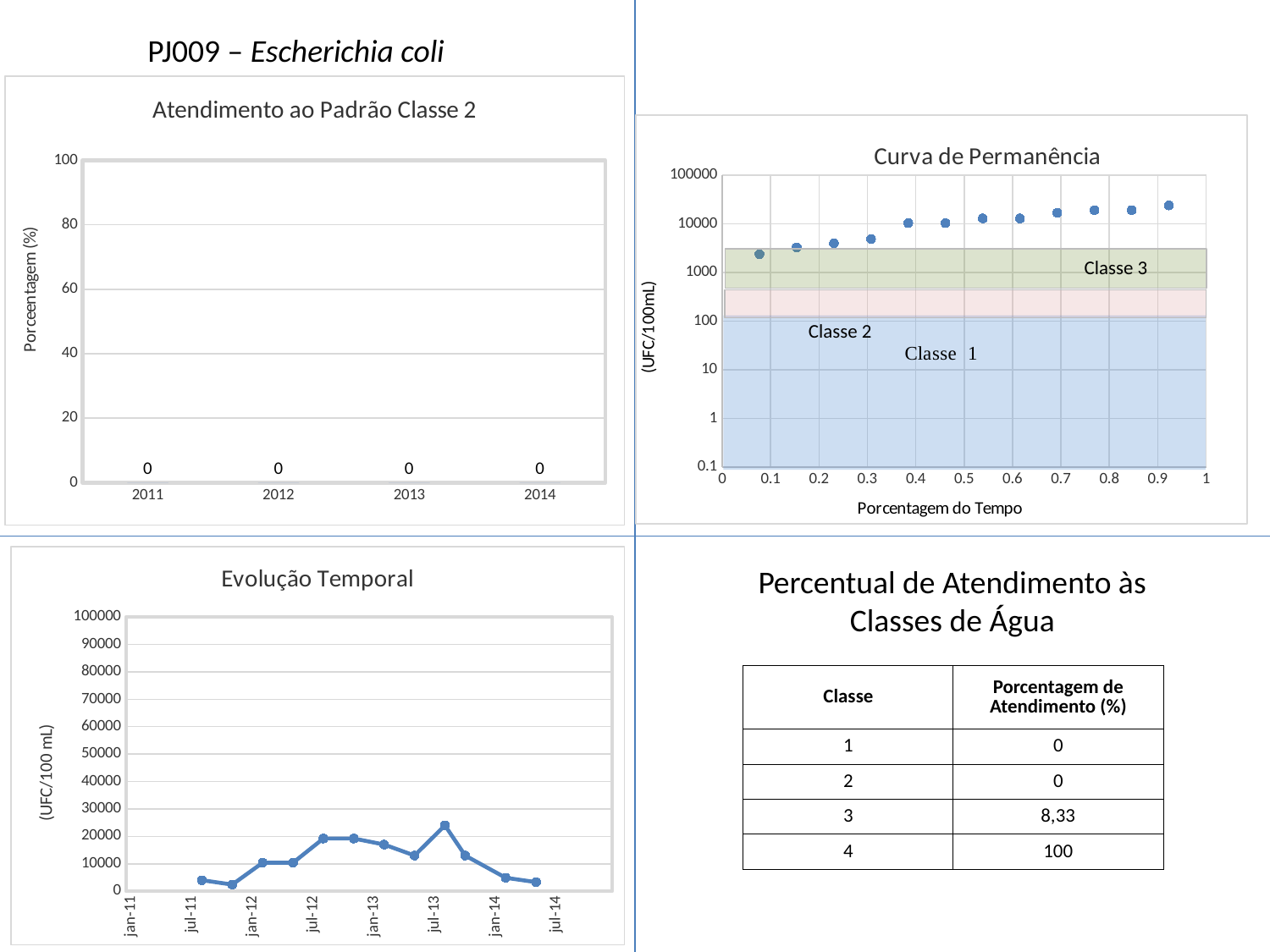
In the 'Curva de Permanência' chart, is the value of the point at about 0.92 on the x axis greater or less than 10000? greater In the 'Evolução Temporal' chart, is the highest point (around jul-13) greater or less than 20000? greater In the 'Atendimento ao Padrão Classe 2' chart, what is the value shown for 2013? 0 What is the x-axis title of the 'Curva de Permanência' chart? Porcentagem do Tempo In the 'Curva de Permanência' chart, do the plotted values rise or fall as the x axis increases? rise What kind of chart is 'Evolução Temporal'? line chart In the 'Curva de Permanência' chart, how many data points are plotted? 12 In the 'Evolução Temporal' chart, which is larger: the value at jul-13 or the value at jan-14? jul-13 In the 'Curva de Permanência' chart, is the value of the first point (near 0.1 on the x axis) greater or less than 10000? less In the 'Atendimento ao Padrão Classe 2' chart, what is the value shown for 2011? 0 What is the y-axis title of the 'Atendimento ao Padrão Classe 2' chart? Porceentagem (%) In the 'Atendimento ao Padrão Classe 2' chart, how many years are shown on the x axis? 4